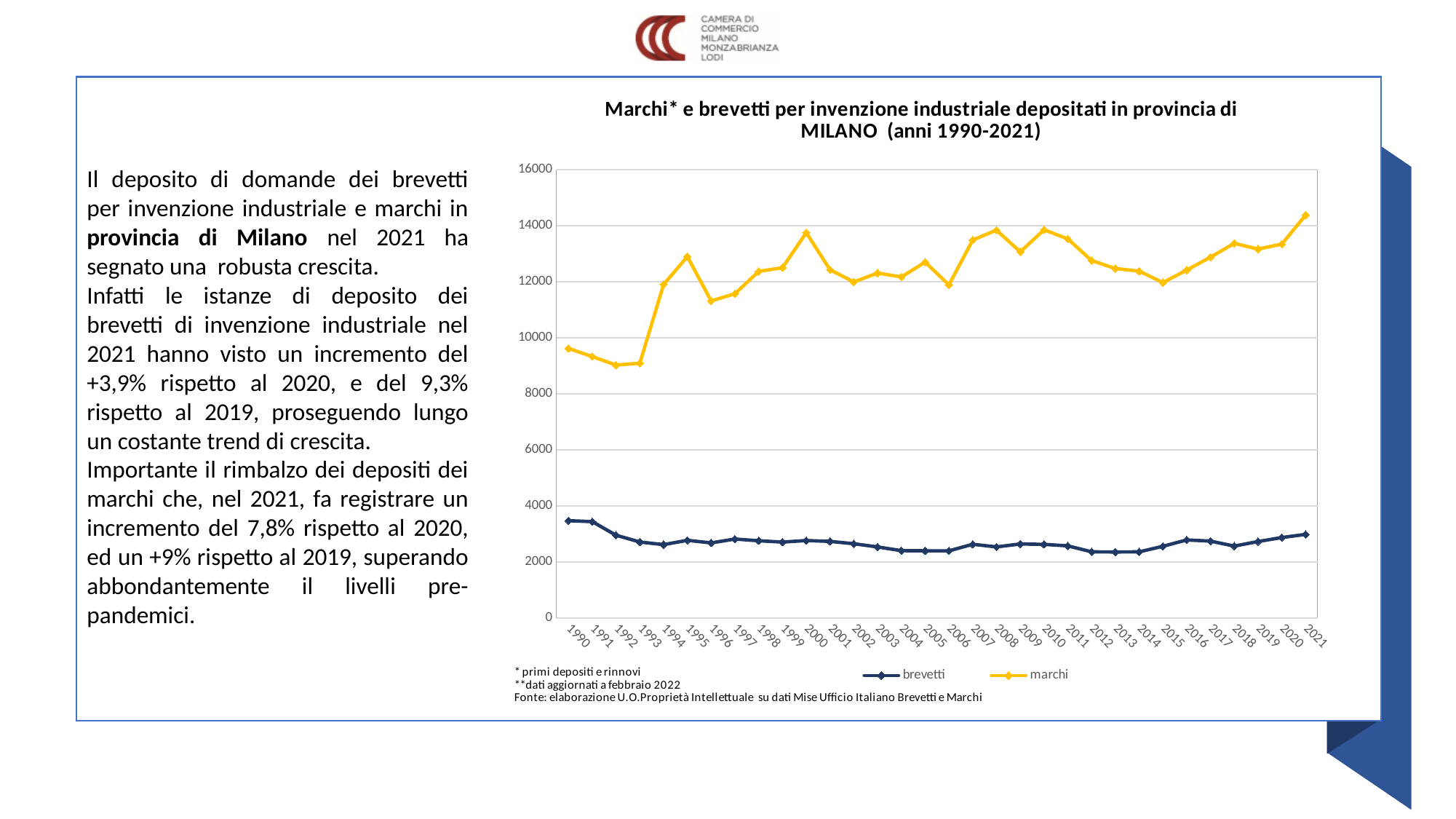
How many years are plotted along the x axis? 32 Which two series are listed in the chart legend? brevetti and marchi Is the value for brevetti in 1990 greater or less than 4000? less Does the marchi series overall rise or fall from 1990 to 2021? rise Is the value for marchi in 2021 greater or less than 14000? greater How many series does the legend list? 2 Is the value for marchi in 1992 greater or less than 10000? less In 2021, which series has the larger value, brevetti or marchi? marchi What kind of chart is shown on the slide? line chart In which year does the marchi series reach its highest value? 2021 For the brevetti series, is the value in 1990 larger or smaller than the value in 2021? larger